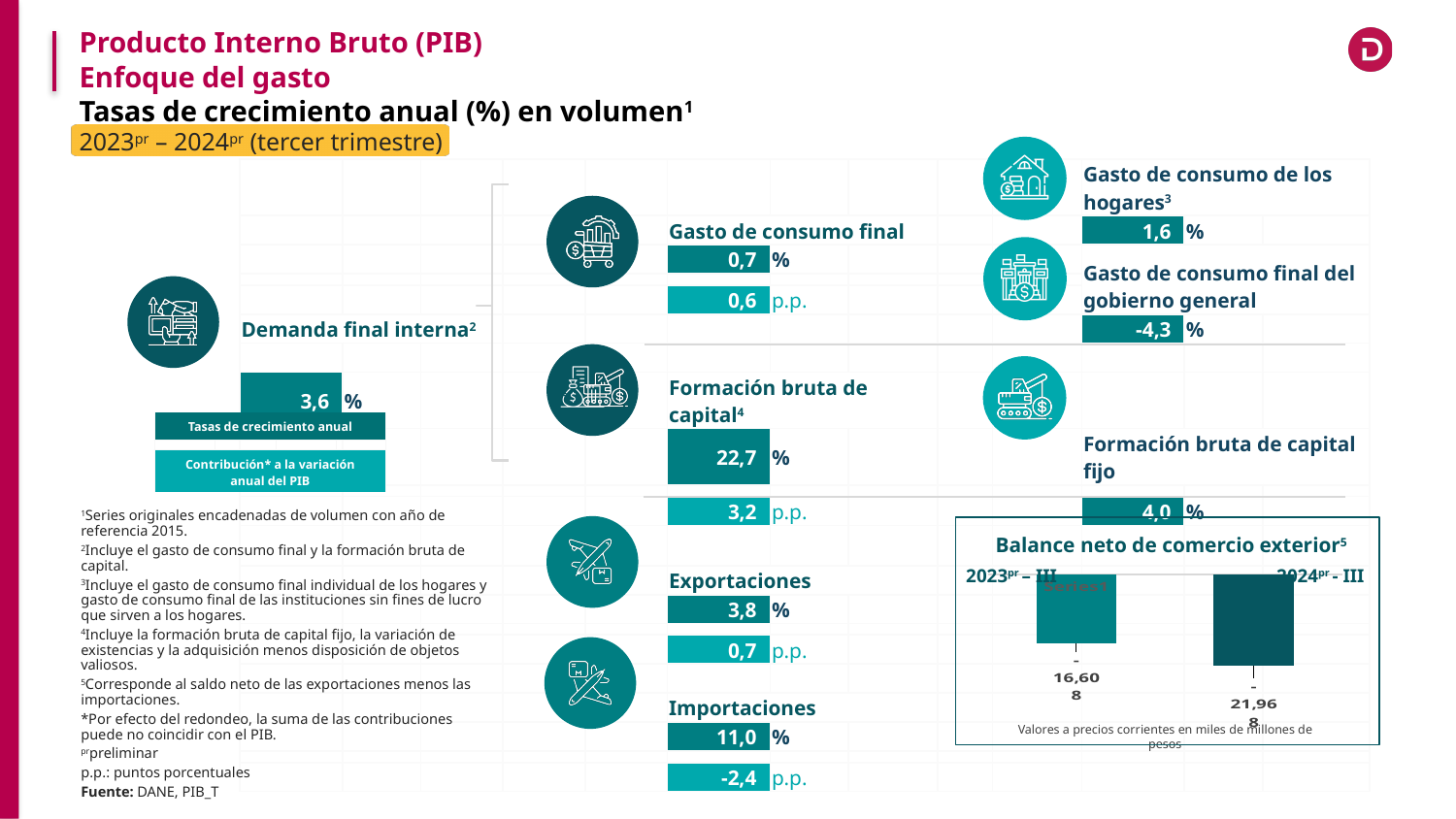
In the 'Balance neto de comercio exterior' chart, which period has the lowest (most negative) value? 2024pr - III What type of chart is 'Balance neto de comercio exterior'? bar chart In the 'Balance neto de comercio exterior' chart, which period has the higher value? 2023pr - III In what units are the values of the 'Balance neto de comercio exterior' chart expressed, according to the note below it? Valores a precios corrientes en miles de millones de pesos In the 'Balance neto de comercio exterior' chart, does the value rise or fall from 2023pr - III to 2024pr - III? fall In the 'Balance neto de comercio exterior' chart, what is the difference between the 2023pr - III and 2024pr - III values? 5,360 How many bars are shown in the 'Balance neto de comercio exterior' chart? 2 In the 'Balance neto de comercio exterior' chart, what is the value for 2023pr - III? -16,608 What is the annual growth rate shown for 'Importaciones'? 11,0 % In the 'Balance neto de comercio exterior' chart, what is the value for 2024pr - III? -21,968 What is the annual growth rate shown for 'Demanda final interna'? 3,6 % What is the annual growth rate shown for 'Gasto de consumo final del gobierno general'? -4,3 %